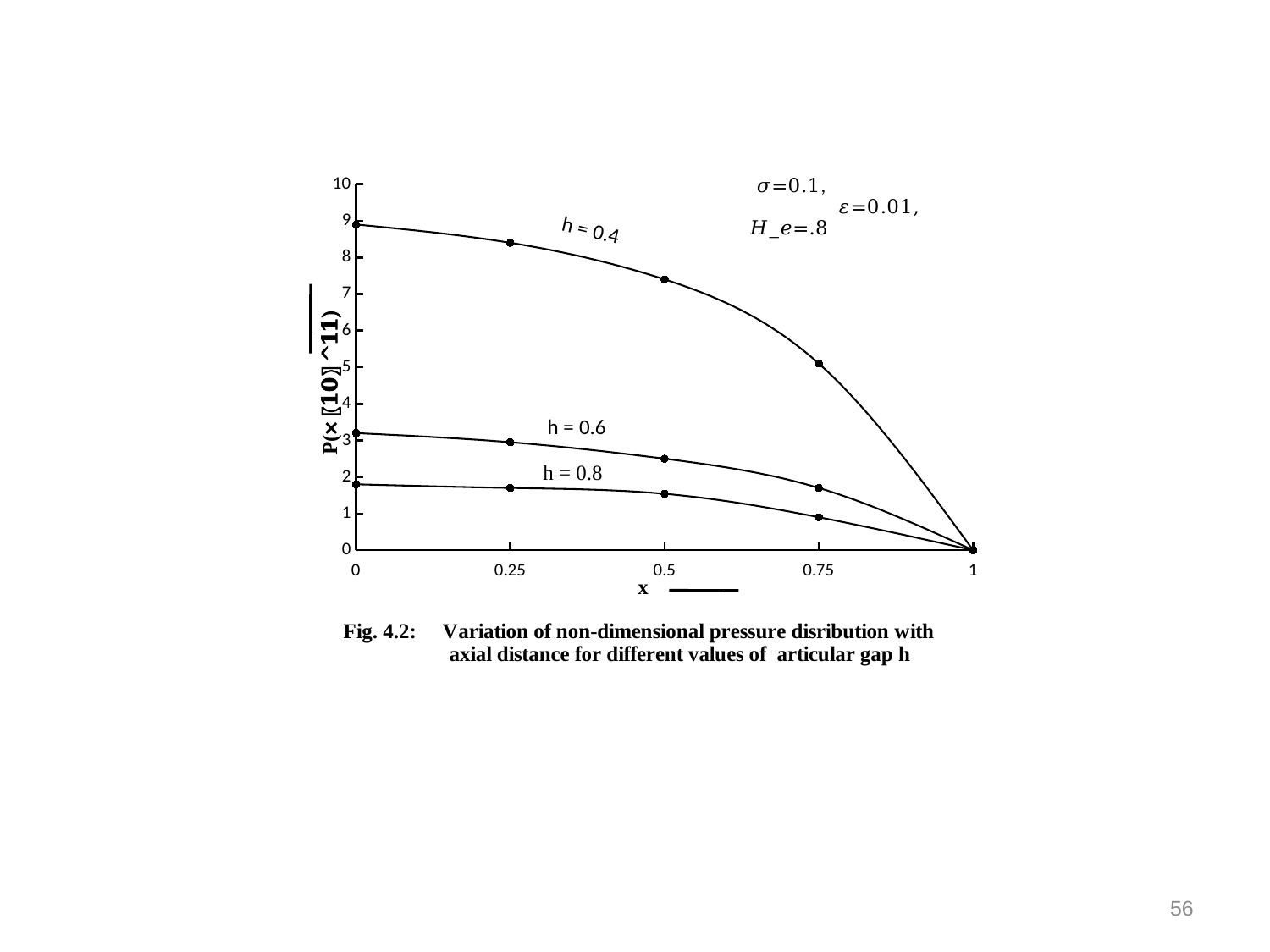
How many x-axis tick values are shown on the chart? 5 What is the value of the h = 0.6 curve at x = 1? 0 How many curves (values of h) are plotted on the chart? 3 Is the value of the h = 0.8 curve at x = 0 greater or less than 2? less At x = 0.5, which curve has the larger value, h = 0.4 or h = 0.6? h = 0.4 Is the value of the h = 0.4 curve at x = 0.75 greater or less than 4? greater Which curve has the lowest value at x = 0? h = 0.8 Which curve has the highest value at x = 0? h = 0.4 Is the value of the h = 0.4 curve at x = 0 greater or less than 8? greater What kind of chart is shown on the slide? line chart What is the figure number given in the caption below the chart? Fig. 4.2 Do the values of the h = 0.4 curve rise or fall as x increases from 0 to 1? fall